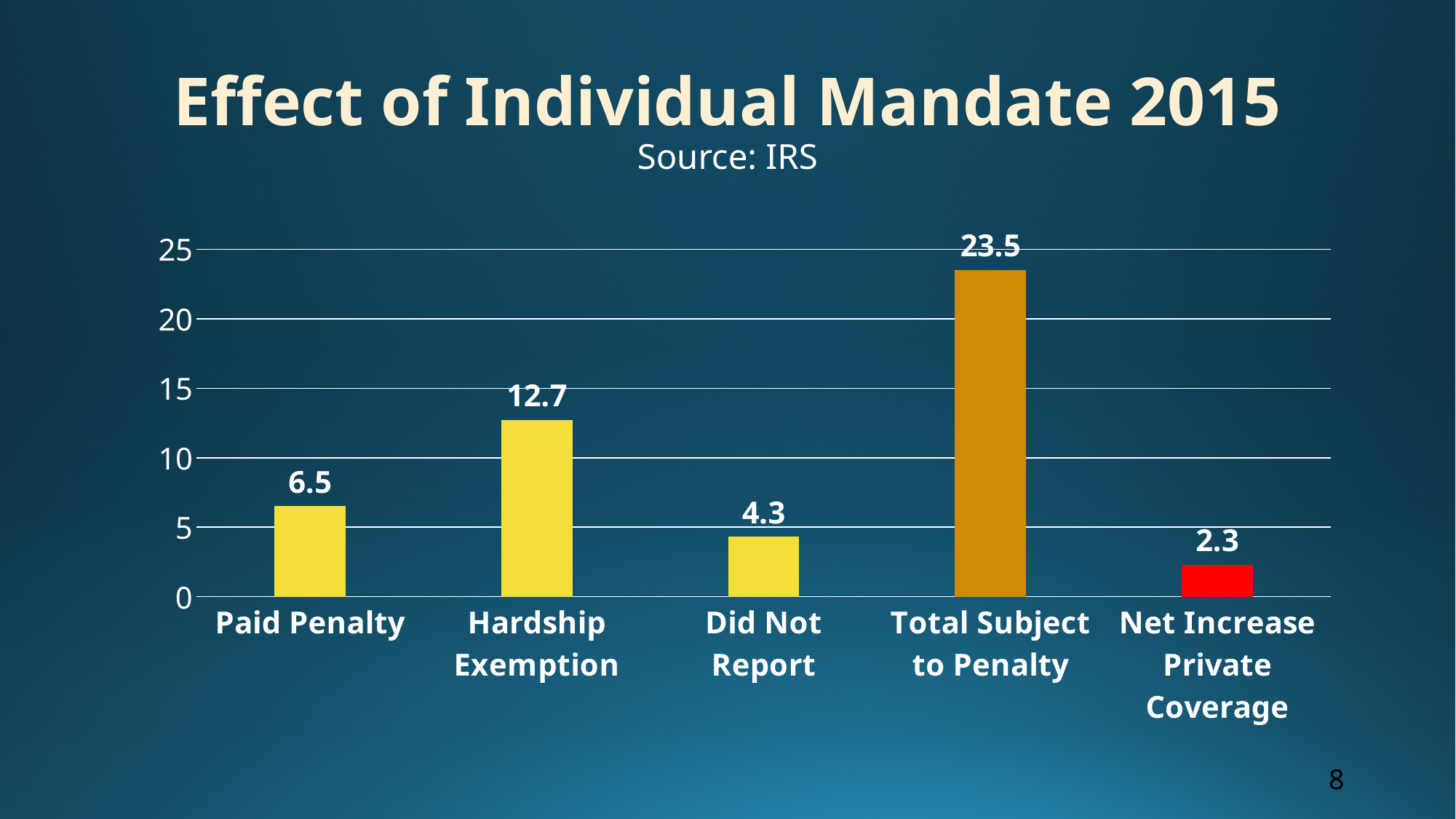
What is the title of the chart? Effect of Individual Mandate 2015 How many categories are shown on the x axis? 5 Which category has the highest value? Total Subject to Penalty What is the difference between Total Subject to Penalty and Hardship Exemption? 10.8 What is the value for Net Increase Private Coverage? 2.3 What is the value for Hardship Exemption? 12.7 Is the value for Hardship Exemption greater or less than 10? greater What is the value for Did Not Report? 4.3 What is the value for Paid Penalty? 6.5 Which is larger, Paid Penalty or Did Not Report? Paid Penalty Which category has the lowest value? Net Increase Private Coverage What kind of chart is shown on the slide? bar chart